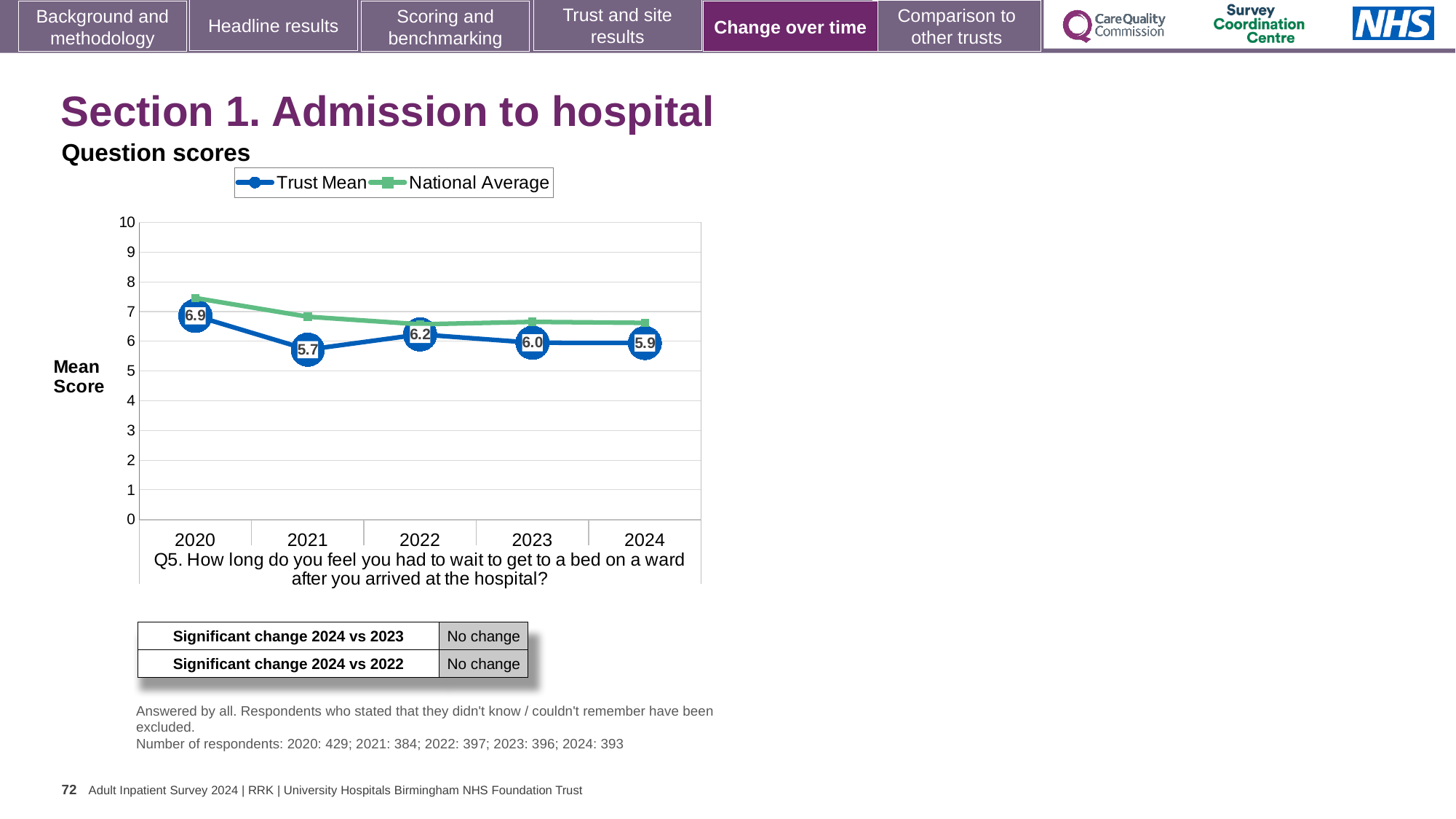
In which year is the Trust Mean score lowest? 2021 Is the National Average value for 2020 greater or less than 7? greater How many series does the chart legend list? 2 What kind of chart is shown on the slide? Line chart Is the National Average value for 2024 greater or less than 7? less In which year is the Trust Mean score highest? 2020 What is the Trust Mean score for 2021? 5.7 What is the difference between the Trust Mean scores for 2020 and 2021? 1.2 Which is larger, the Trust Mean score for 2022 or for 2021? 2022 How many years are shown on the x axis of the chart? 5 What is the Trust Mean score for 2024? 5.9 What is the Trust Mean score for 2020? 6.9